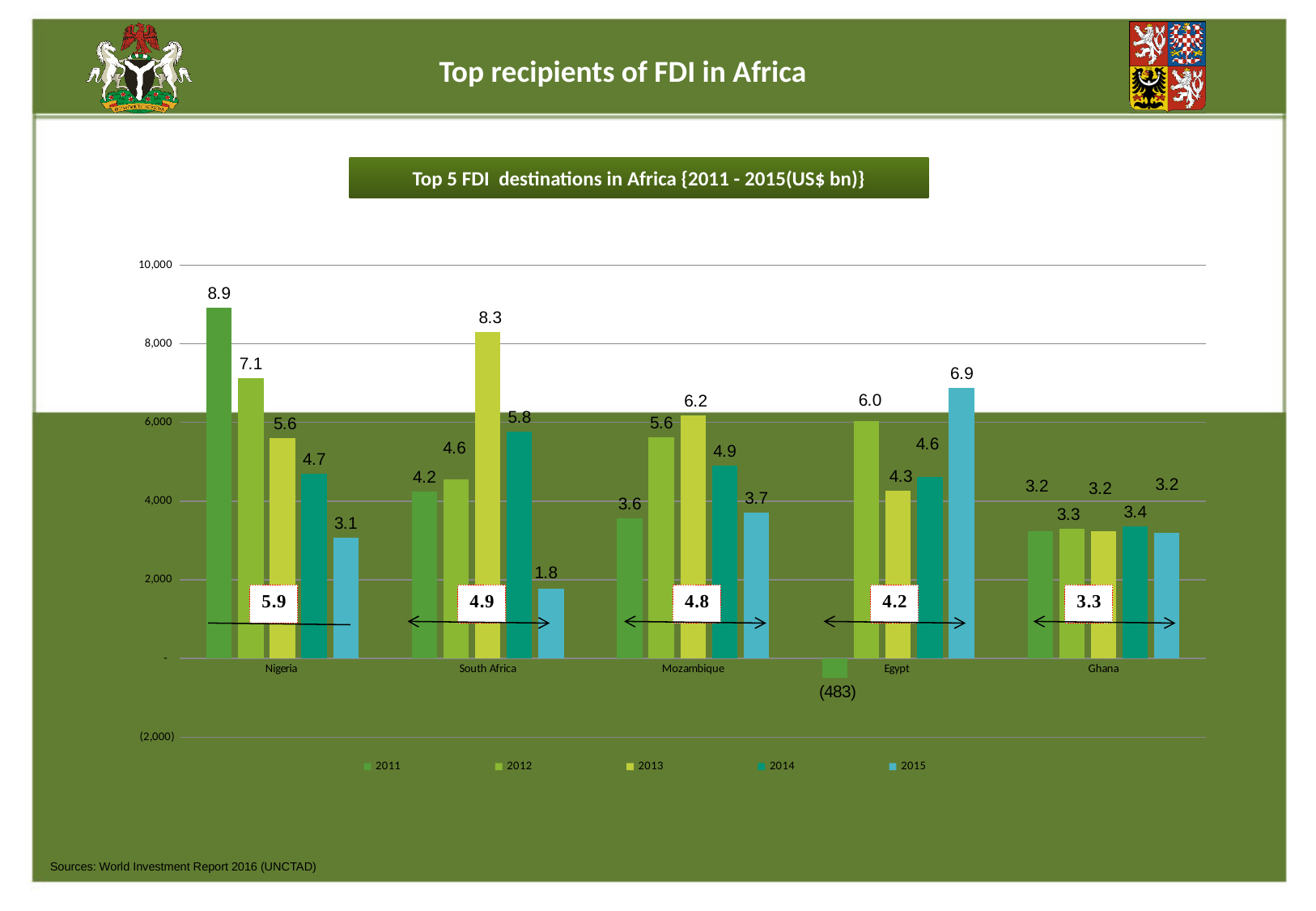
What is the value for Egypt in 2015? 6.9 What is the value for Nigeria in 2011? 8.9 What is the value for South Africa in 2013? 8.3 What is the value for Mozambique in 2012? 5.6 Which country has the highest value in 2011? Nigeria Do Nigeria's values rise or fall from 2011 to 2015? fall Which is larger, Mozambique's 2013 value or Egypt's 2013 value? Mozambique's 2013 value How many series does the legend list? 5 What kind of chart is shown on the slide? bar chart What is the difference between Nigeria's 2011 value and its 2015 value? 5.8 Which country has the lowest value in 2015? South Africa How many countries are shown on the x axis? 5